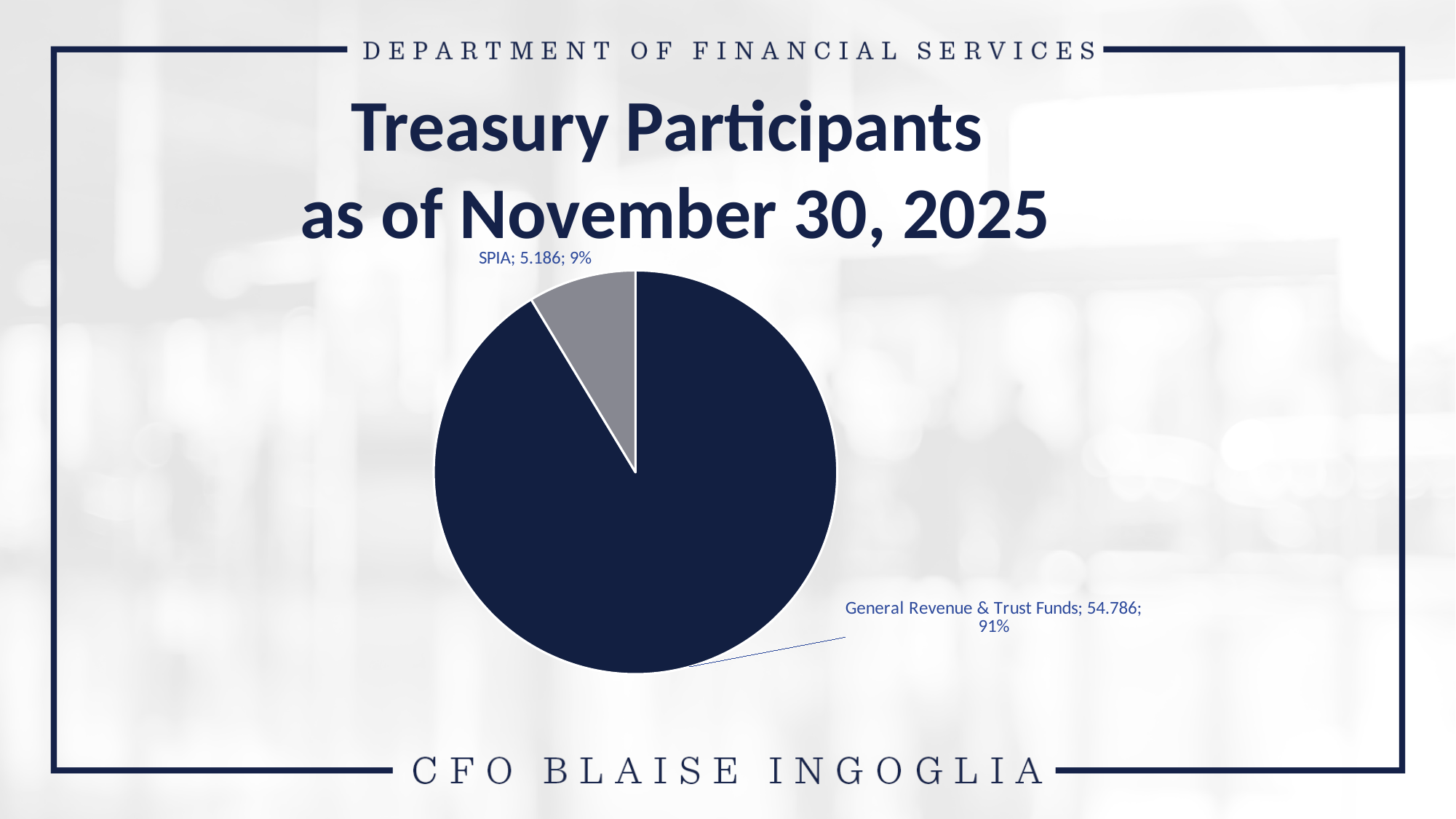
Which slice is the largest? General Revenue & Trust Funds What is the value for SPIA? 5.186 How many slices does the pie chart have? 2 What kind of chart is shown on the slide? pie chart Which is larger, the value for SPIA or the value for General Revenue & Trust Funds? General Revenue & Trust Funds What is the difference between the values for General Revenue & Trust Funds and SPIA? 49.600 What share of the pie does General Revenue & Trust Funds represent? 91% What is the value for General Revenue & Trust Funds? 54.786 Which slice is the smallest? SPIA What is the title of the chart on the slide? Treasury Participants as of November 30, 2025 What is the total of the two slice values? 59.972 What share of the pie does SPIA represent? 9%